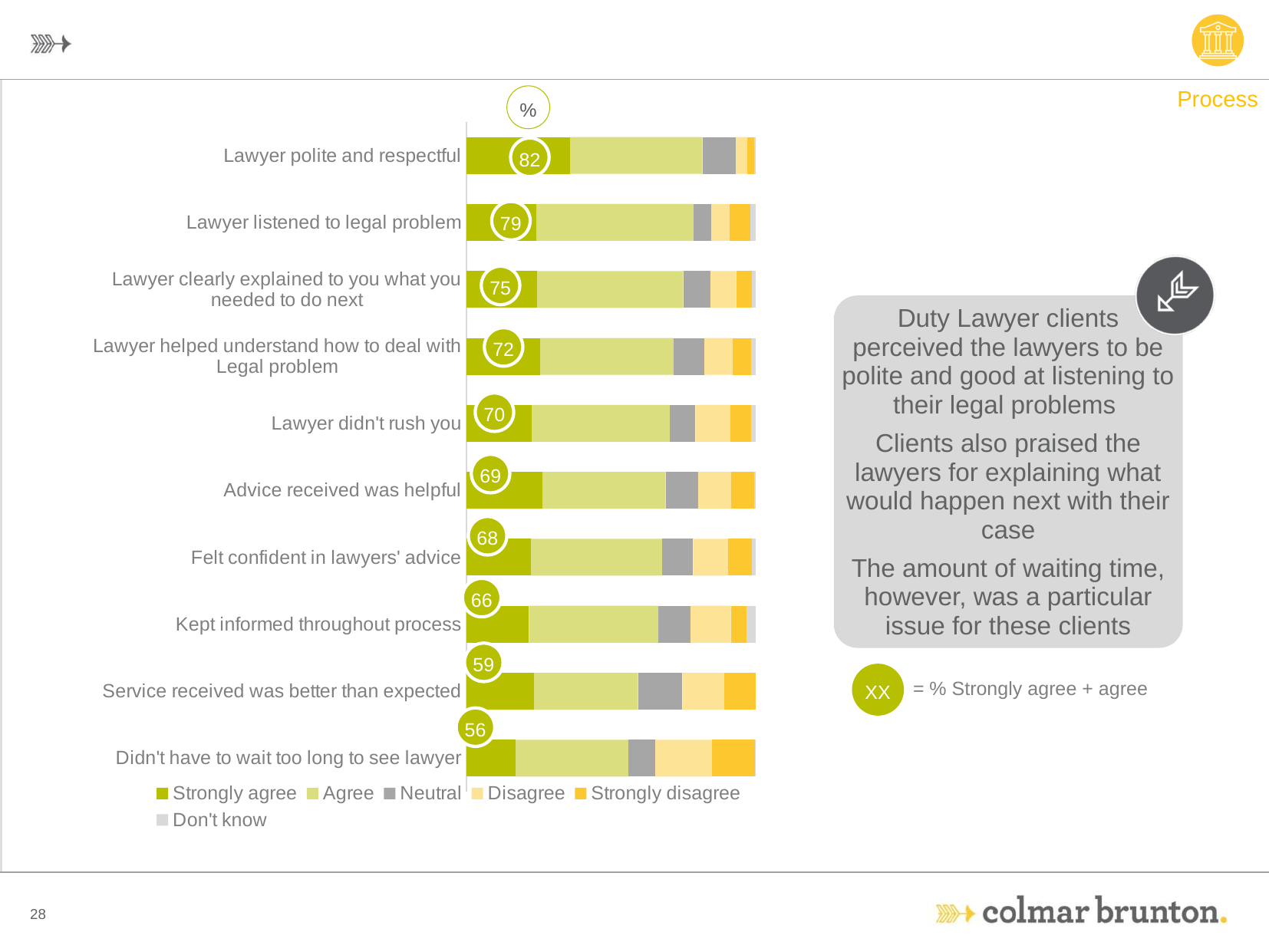
What is the difference between the combined agreement percentages for "Lawyer listened to legal problem" and "Service received was better than expected"? 20 What is the combined percentage of strongly agree and agree for "Lawyer polite and respectful"? 82 Which statement has the highest combined strongly agree plus agree percentage? Lawyer polite and respectful How many statements are shown in the chart? 10 What is the combined percentage of strongly agree and agree for "Didn't have to wait too long to see lawyer"? 56 How many series does the legend list? 6 According to the key on the slide, what do the circled numbers represent? % Strongly agree + agree Which statement has the lowest combined strongly agree plus agree percentage? Didn't have to wait too long to see lawyer What kind of chart is shown on the slide? Stacked bar chart What is the combined percentage of strongly agree and agree for "Kept informed throughout process"? 66 What is the difference between the combined agreement percentages for "Lawyer polite and respectful" and "Didn't have to wait too long to see lawyer"? 26 Which has a higher combined agreement percentage: "Lawyer didn't rush you" or "Felt confident in lawyers' advice"? Lawyer didn't rush you